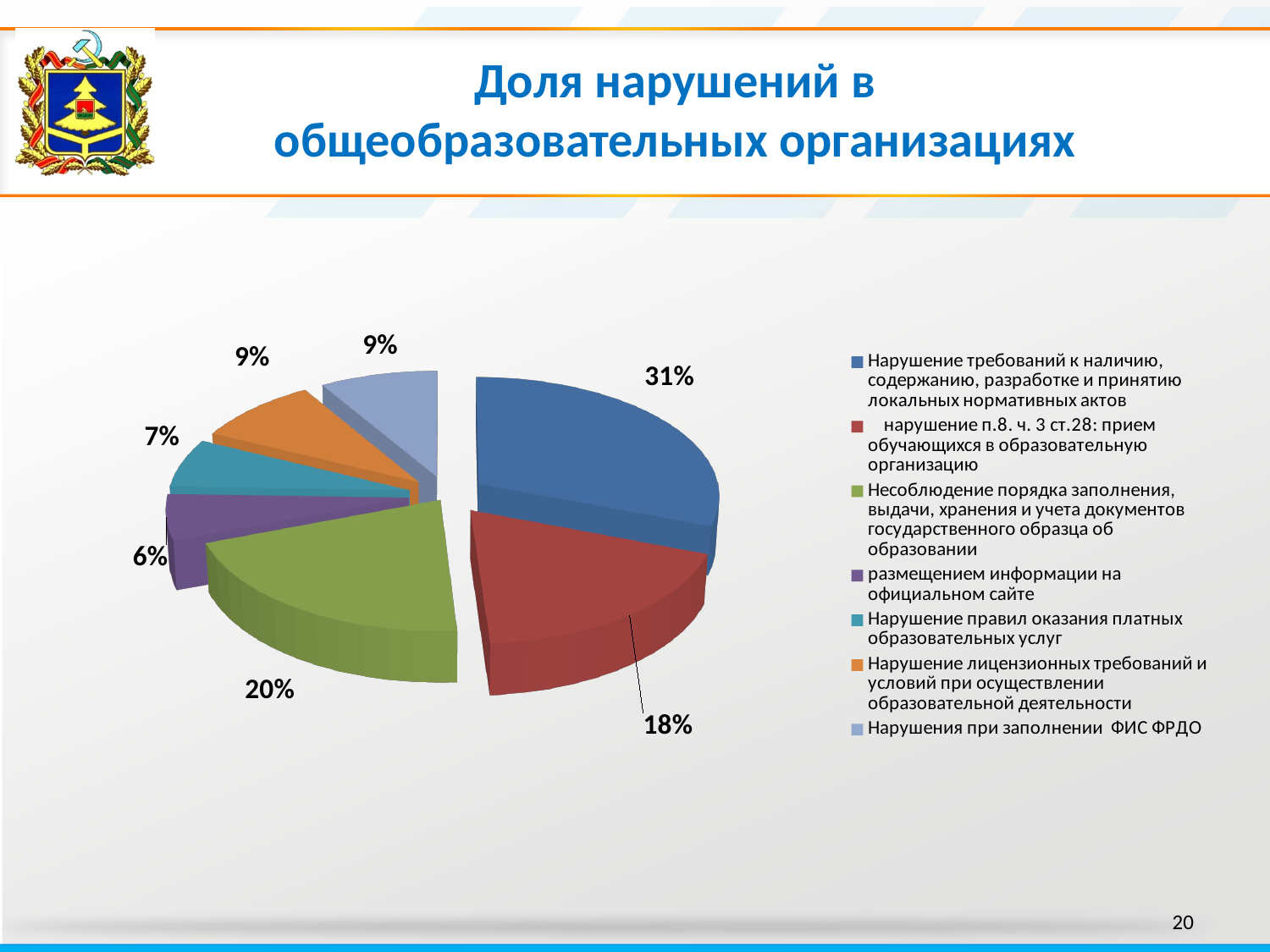
Which category has the smallest share of the pie? размещением информации на официальном сайте What share of the pie is 'нарушение п.8. ч. 3 ст.28: прием обучающихся в образовательную организацию'? 18% What share of the pie is 'Нарушение требований к наличию, содержанию, разработке и принятию локальных нормативных актов'? 31% How many entries does the legend list? 7 What share of the pie is 'Нарушения при заполнении ФИС ФРДО'? 9% What is the title of the chart on the slide? Доля нарушений в общеобразовательных организациях Which category has the largest share of the pie? Нарушение требований к наличию, содержанию, разработке и принятию локальных нормативных актов What share of the pie is 'Несоблюдение порядка заполнения, выдачи, хранения и учета документов государственного образца об образовании'? 20% What is the difference in percentage points between the largest slice (31%) and the 'Несоблюдение порядка заполнения...' slice (20%)? 11 percentage points What kind of chart is shown on the slide? Pie chart What share of the pie is 'размещением информации на официальном сайте'? 6% How many slices does the pie chart have? 7